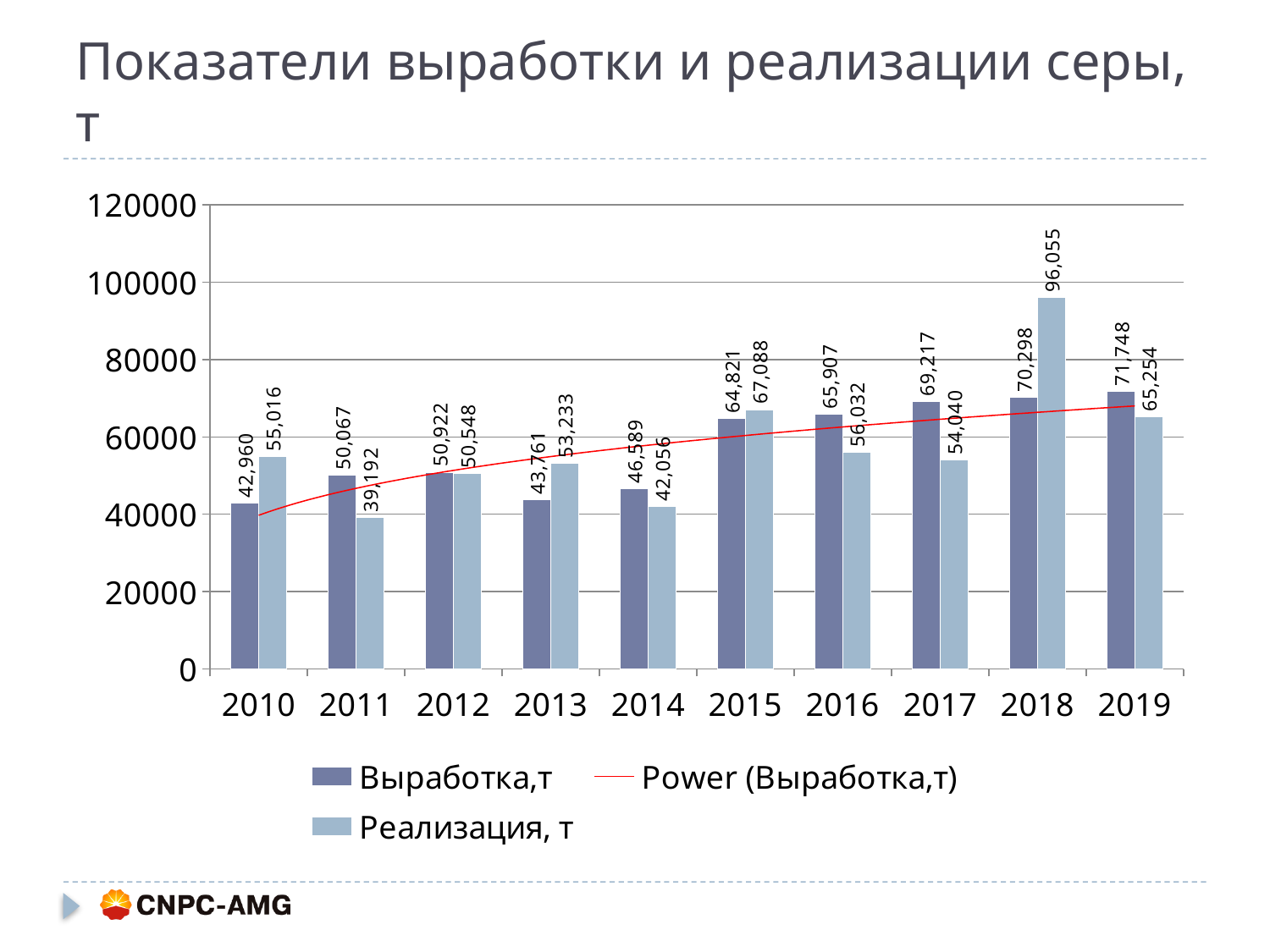
What is the difference between Реализация, т and Выработка,т in 2018? 25,757 What kind of chart is shown on the slide? Bar chart Does the value of Выработка,т rise or fall from 2015 to 2019? Rise What is the value of Реализация, т for 2011? 39,192 How many entries does the legend list? 3 Which is larger in 2010: Выработка,т or Реализация, т? Реализация, т What is the value of Реализация, т for 2018? 96,055 Which year has the highest value of Выработка,т? 2019 Is the value of Выработка,т for 2017 greater or less than 60000? greater What is the value of Выработка,т for 2015? 64,821 How many years are shown on the x axis? 10 Which year has the lowest value of Реализация, т? 2011